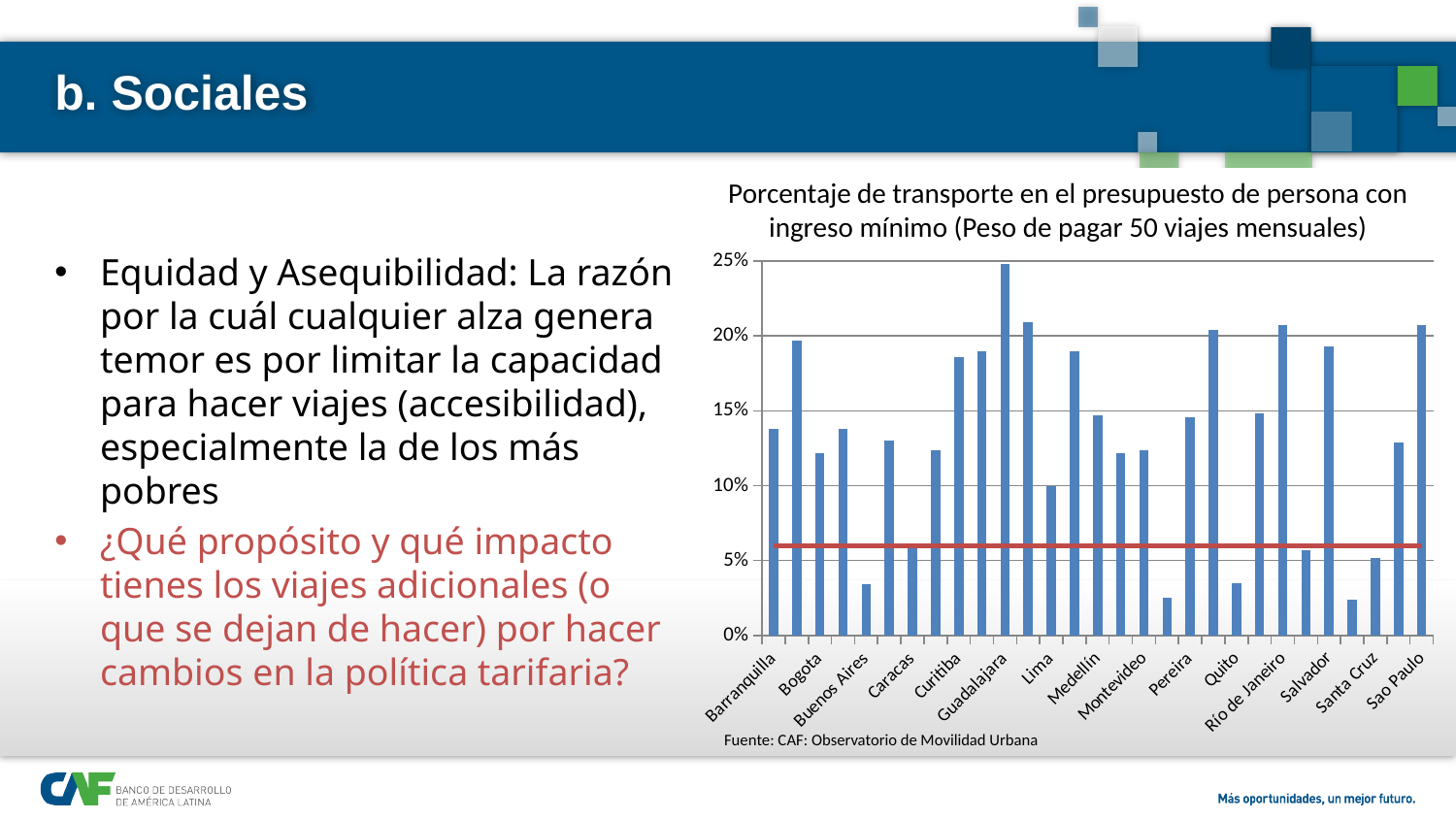
Is the value for Guadalajara greater or less than 15%? greater Is the value for Medellín greater or less than 10%? greater Is the value for Bogota greater or less than 10%? greater What is the highest value shown on the y axis of the chart? 25% What is the source cited below the chart? CAF: Observatorio de Movilidad Urbana How many city labels are shown on the x axis of the chart? 15 What kind of chart is shown on the slide? combination bar and line chart What is the title of the chart? Porcentaje de transporte en el presupuesto de persona con ingreso mínimo (Peso de pagar 50 viajes mensuales)